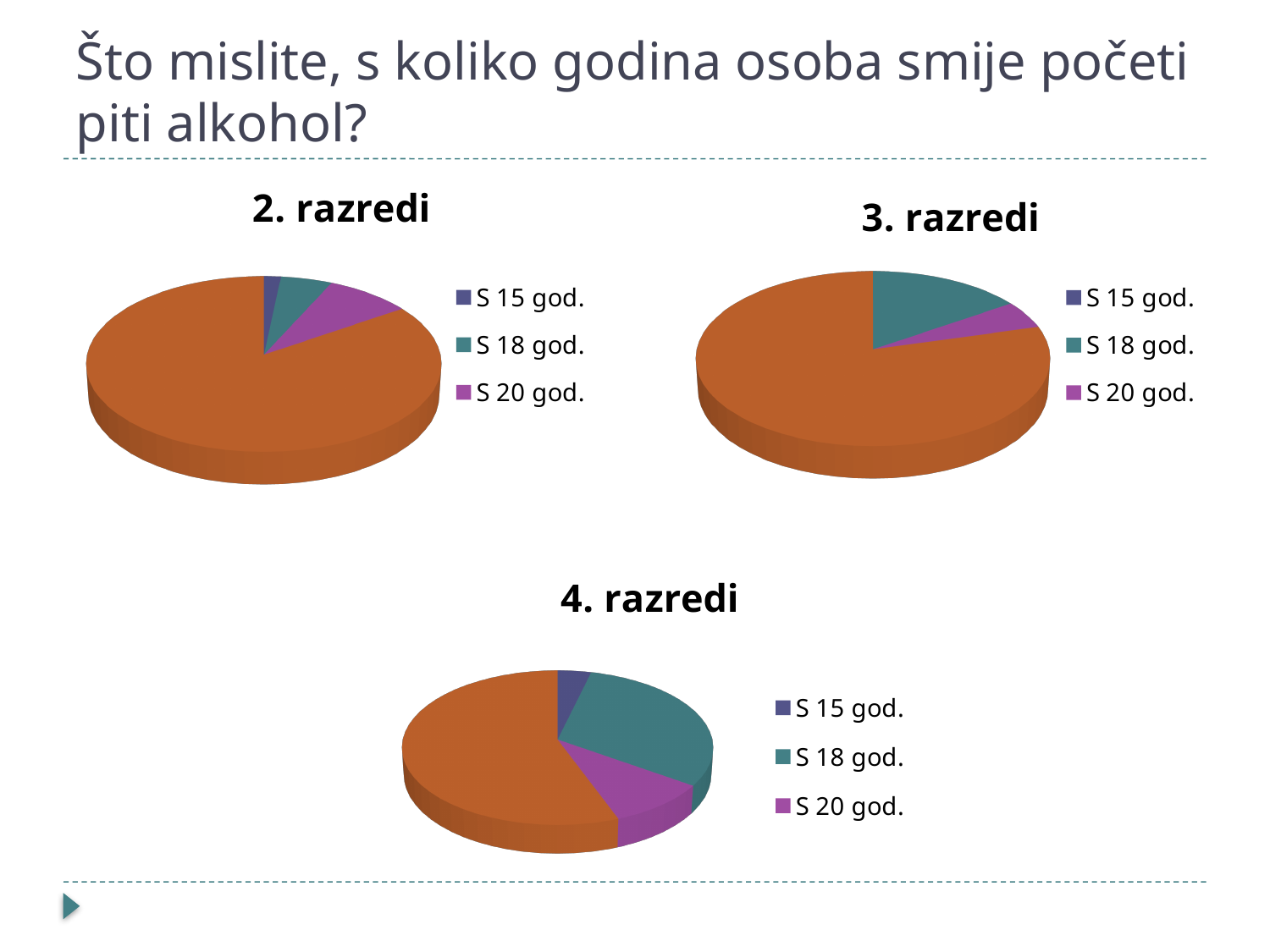
How many pie charts are shown on the slide? 3 In the "2. razredi" chart, which of the legend entries has the smallest slice? S 15 god. What is the title of the pie chart at the bottom of the slide? 4. razredi What kind of chart is the "4. razredi" chart? pie chart What kind of chart is the "2. razredi" chart? pie chart How many entries does the legend of the "3. razredi" chart list? 3 In the "2. razredi" chart, which is larger, the slice for S 18 god. or the slice for S 15 god.? S 18 god. In the "4. razredi" chart, which is larger, the slice for S 18 god. or the slice for S 20 god.? S 18 god. In the "4. razredi" chart, which is larger, the slice for S 20 god. or the slice for S 15 god.? S 20 god. How many entries does the legend of the "4. razredi" chart list? 3 In the "4. razredi" chart, which of the legend entries has the smallest slice? S 15 god.